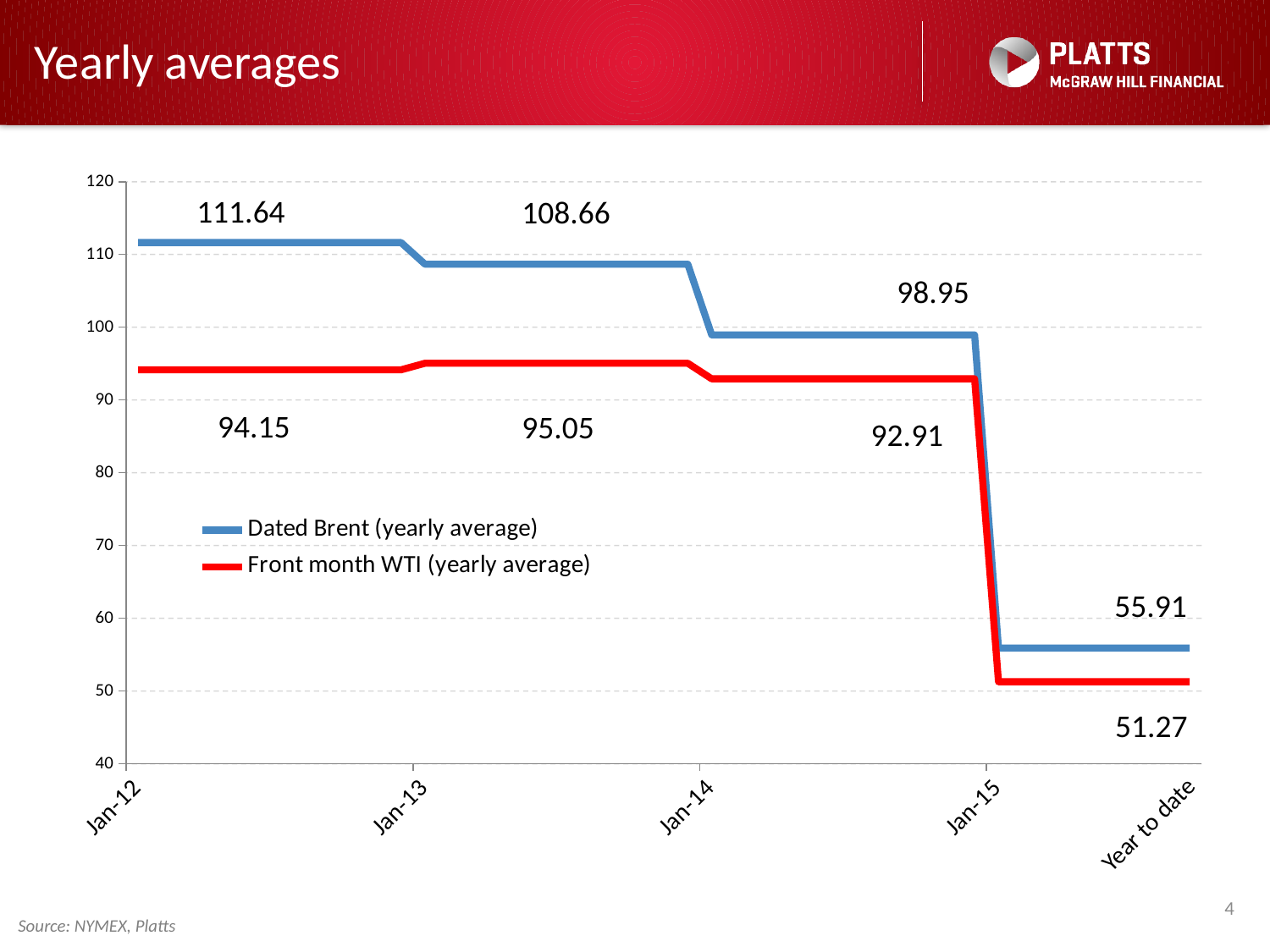
Does the Dated Brent (yearly average) line generally rise or fall from Jan-12 to Year to date? fall What is the difference between the Year to date values for Dated Brent (55.91) and Front month WTI (51.27)? 4.64 What is the Dated Brent (yearly average) value labelled for the period starting Jan-14? 98.95 How many series does the legend list? 2 What is the difference between the Dated Brent value 111.64 and the Front month WTI value 94.15 for the period starting Jan-12? 17.49 What is the highest value labelled on the Dated Brent (yearly average) line? 111.64 What is the lowest value labelled on the Front month WTI (yearly average) line? 51.27 What is the title of the slide containing the chart? Yearly averages What is the Front month WTI (yearly average) value labelled for the period starting Jan-13? 95.05 Which series has the higher value for the period starting Jan-14, Dated Brent or Front month WTI? Dated Brent What is the Dated Brent (yearly average) value labelled at the Year to date end of the chart? 55.91 What kind of chart is shown on the slide? line chart